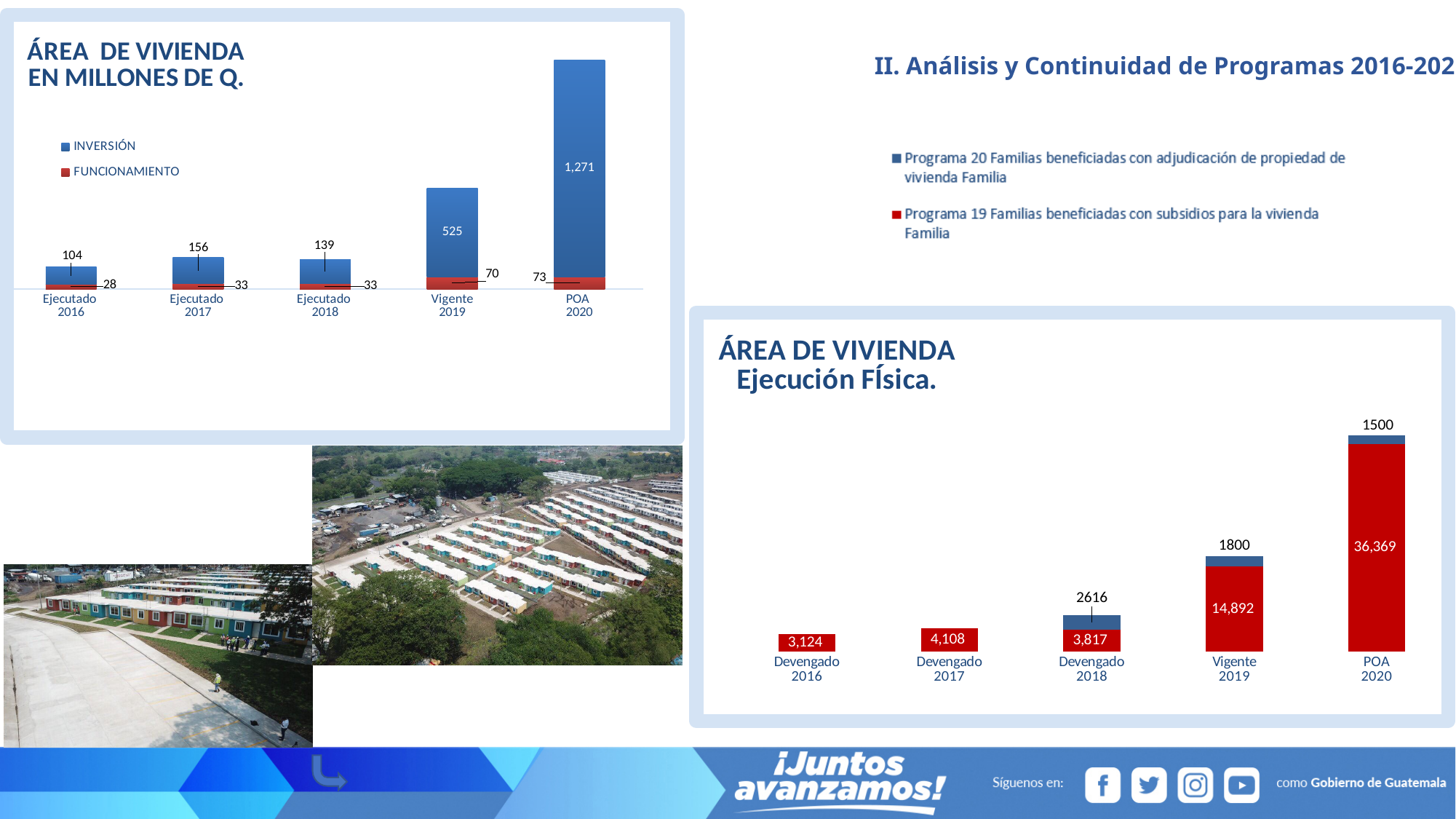
In the chart 'ÁREA DE VIVIENDA Ejecución Física.', what is the Programa 20 value for Vigente 2019? 1800 In the chart 'ÁREA DE VIVIENDA EN MILLONES DE Q.', which category has the lowest INVERSIÓN value? Ejecutado 2016 In the chart 'ÁREA DE VIVIENDA Ejecución Física.', is the Programa 19 value for Devengado 2017 larger or smaller than for Devengado 2018? Larger In the chart 'ÁREA DE VIVIENDA EN MILLONES DE Q.', what is the total of the stacked bar for Ejecutado 2017? 189 How many categories are shown on the x axis of the chart 'ÁREA DE VIVIENDA Ejecución Física.'? 5 In the chart 'ÁREA DE VIVIENDA EN MILLONES DE Q.', what is the FUNCIONAMIENTO value for Vigente 2019? 70 In the chart 'ÁREA DE VIVIENDA Ejecución Física.', what is the Programa 19 value for POA 2020? 36,369 In the chart 'ÁREA DE VIVIENDA EN MILLONES DE Q.', what is the difference between the INVERSIÓN values for Vigente 2019 and Ejecutado 2018? 386 What kind of chart is 'ÁREA DE VIVIENDA Ejecución Física.'? Bar chart How many series does the legend of the chart 'ÁREA DE VIVIENDA EN MILLONES DE Q.' list? 2 In the chart 'ÁREA DE VIVIENDA EN MILLONES DE Q.', what is the INVERSIÓN value for POA 2020? 1,271 In the chart 'ÁREA DE VIVIENDA Ejecución Física.', which category has the highest Programa 19 value? POA 2020